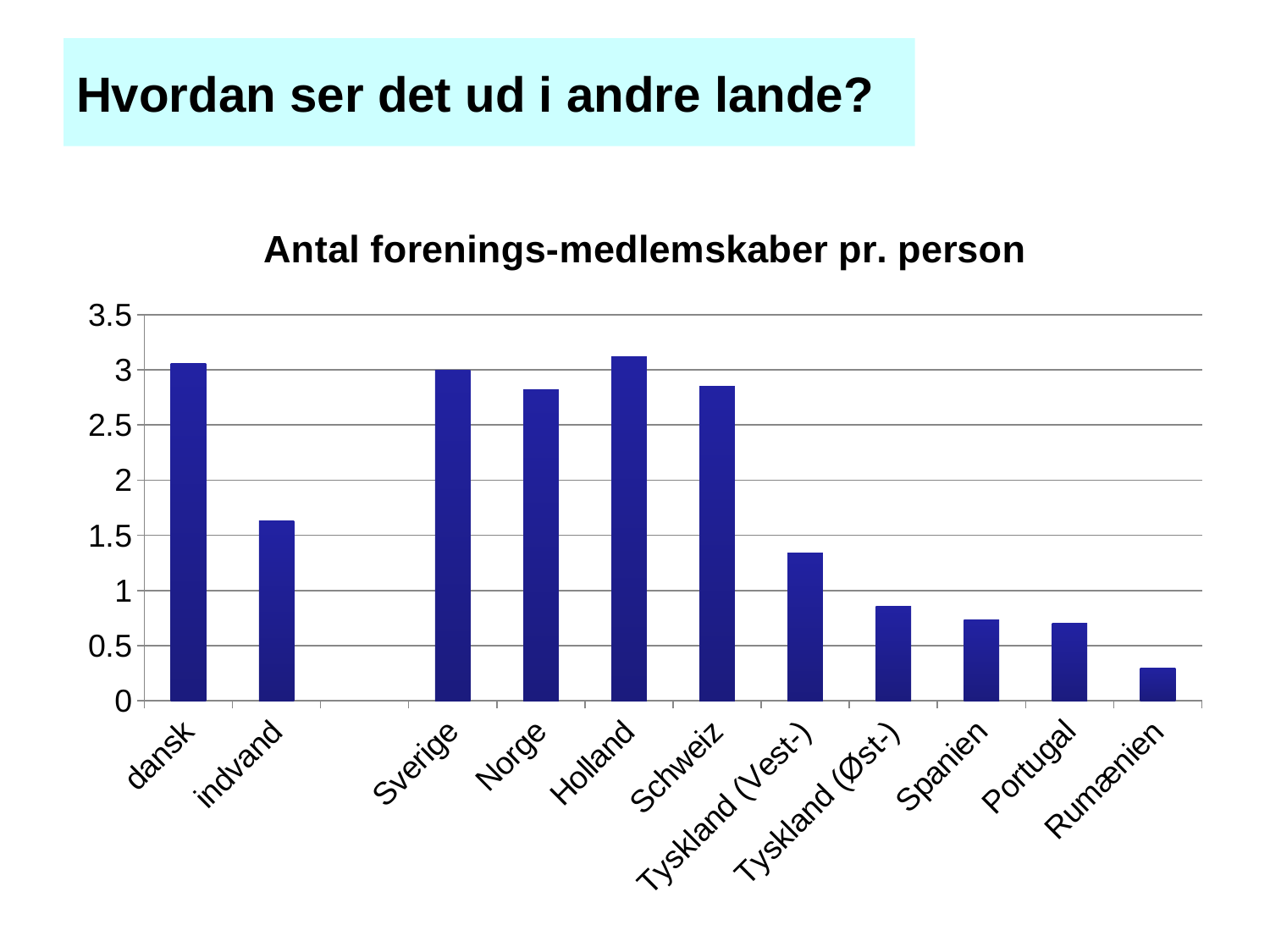
How many categories (bars) are shown in the chart? 11 What is the title of the chart? Antal forenings-medlemskaber pr. person Is the value for indvand greater or less than 1.5? greater Is the value for Tyskland (Øst-) greater or less than 1? less Is the value for Norge greater or less than 2.5? greater Which has a larger value, indvand or Tyskland (Vest-)? indvand Which has a larger value, Portugal or Rumænien? Portugal Which category has the lowest value in the chart? Rumænien Which has a larger value, Sverige or Tyskland (Øst-)? Sverige What kind of chart is shown on the slide? bar chart